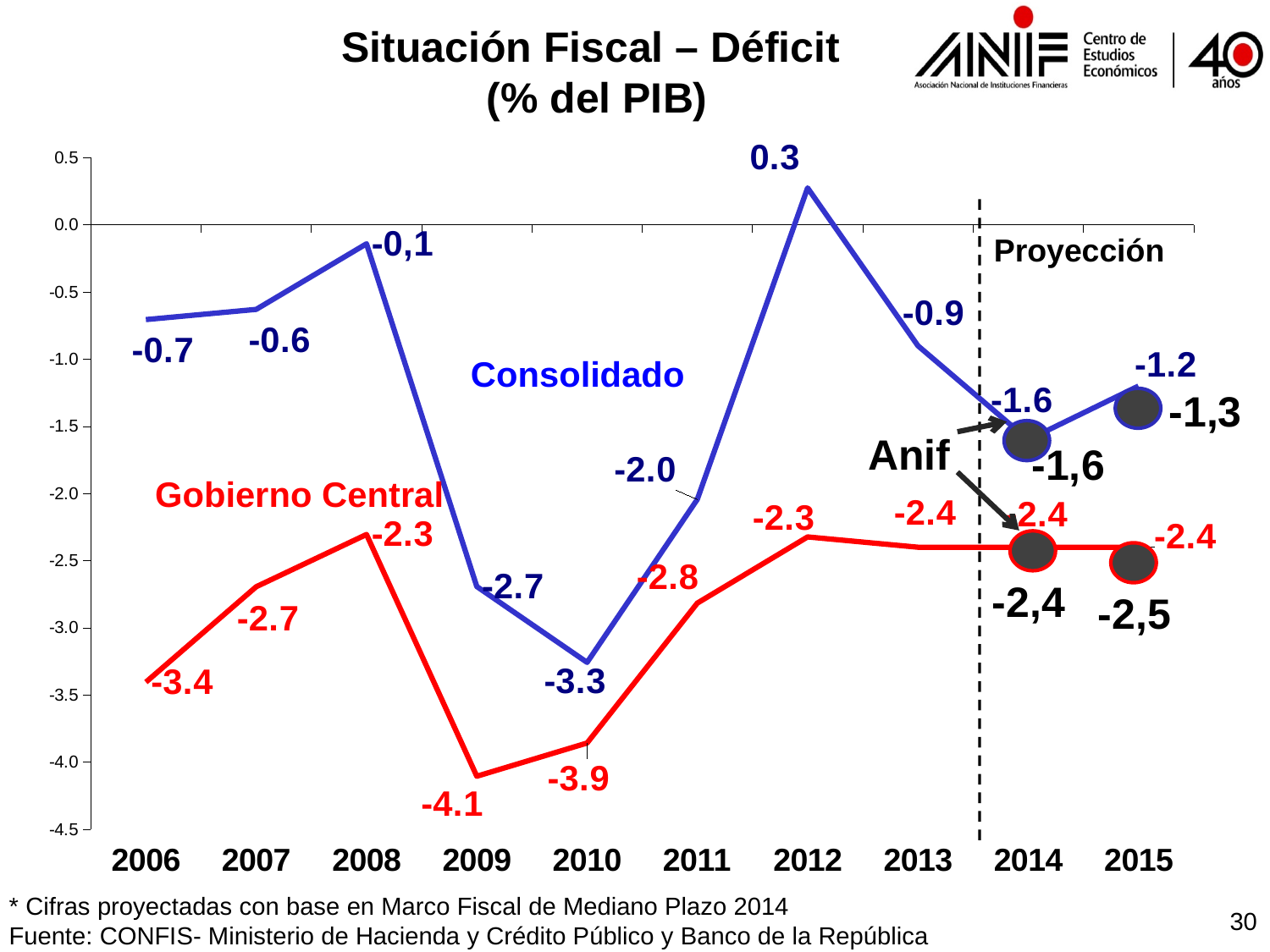
What is the Consolidado value for 2012? 0.3 What kind of chart is shown on the slide? line chart What label marks the area to the right of the dashed vertical line? Proyección What is the Anif projection for Gobierno Central in 2015? -2,5 In 2010, which series has the higher value, Consolidado or Gobierno Central? Consolidado How many data series (lines) are plotted on the chart? 2 How many years are shown on the x axis? 10 In which year does the Consolidado line reach its highest value? 2012 What is the Consolidado value for 2013? -0.9 What is the Gobierno Central value for 2009? -4.1 In which year is the Gobierno Central deficit at its lowest (most negative) value? 2009 What is the difference between the Gobierno Central values for 2007 (-2.7) and 2006 (-3.4)? 0.7